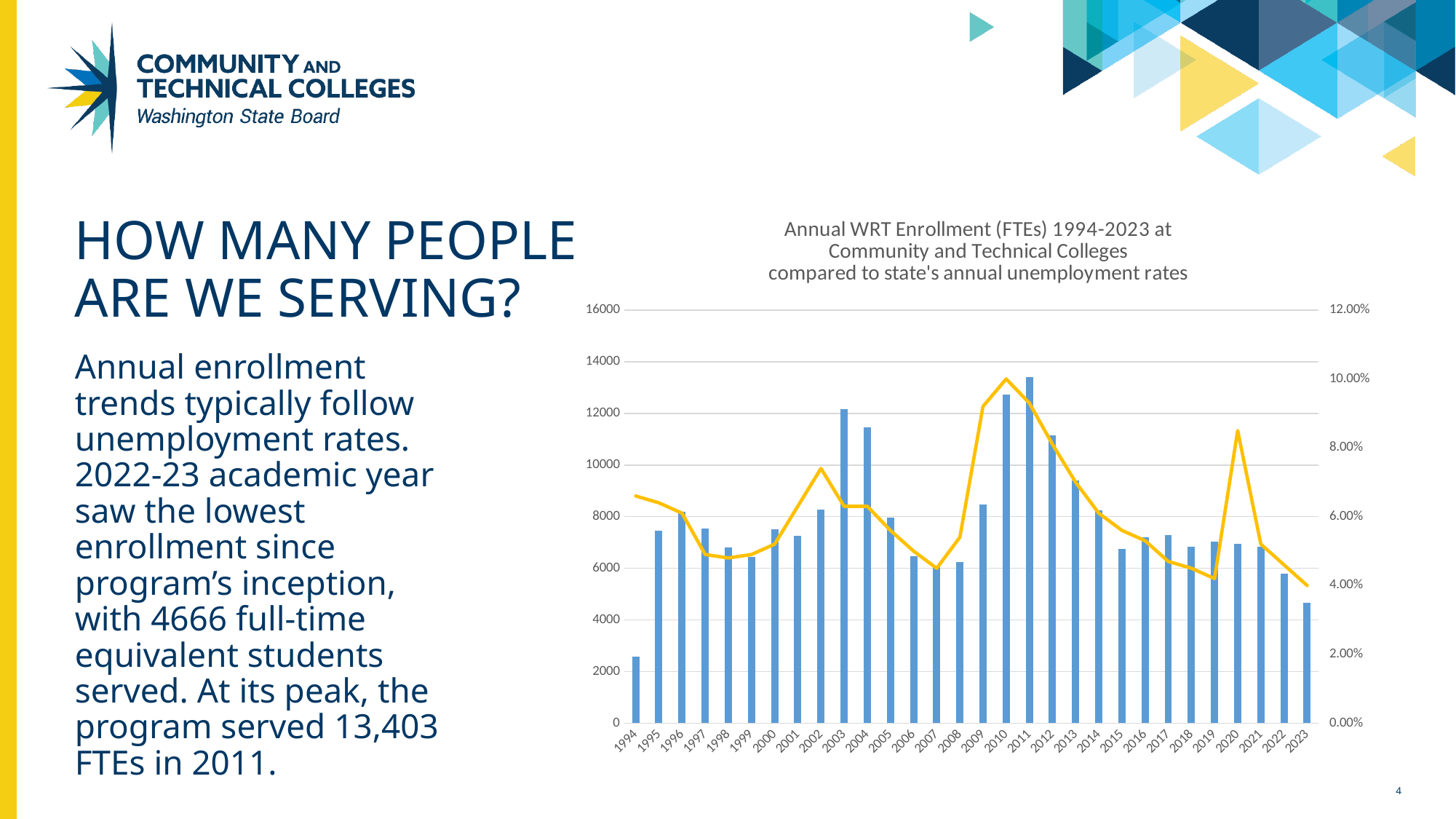
What kind of chart is shown on the slide? bar chart with a line According to the slide, how many FTEs did the program serve at its peak in 2011? 13,403 Do the enrollment bars generally rise or fall from 2011 to 2023? fall In which year does the unemployment rate line reach its highest point? 2010 Which year has a higher enrollment bar, 2003 or 2004? 2003 Which year has the lowest WRT enrollment bar? 1994 How many years are shown on the x axis of the chart? 30 Which year has the highest WRT enrollment bar? 2011 Is the unemployment rate line for 2020 greater or less than 8.00%? greater Is the enrollment bar for 2023 greater or less than 6000? less Is the enrollment bar for 2010 greater or less than 12000? greater